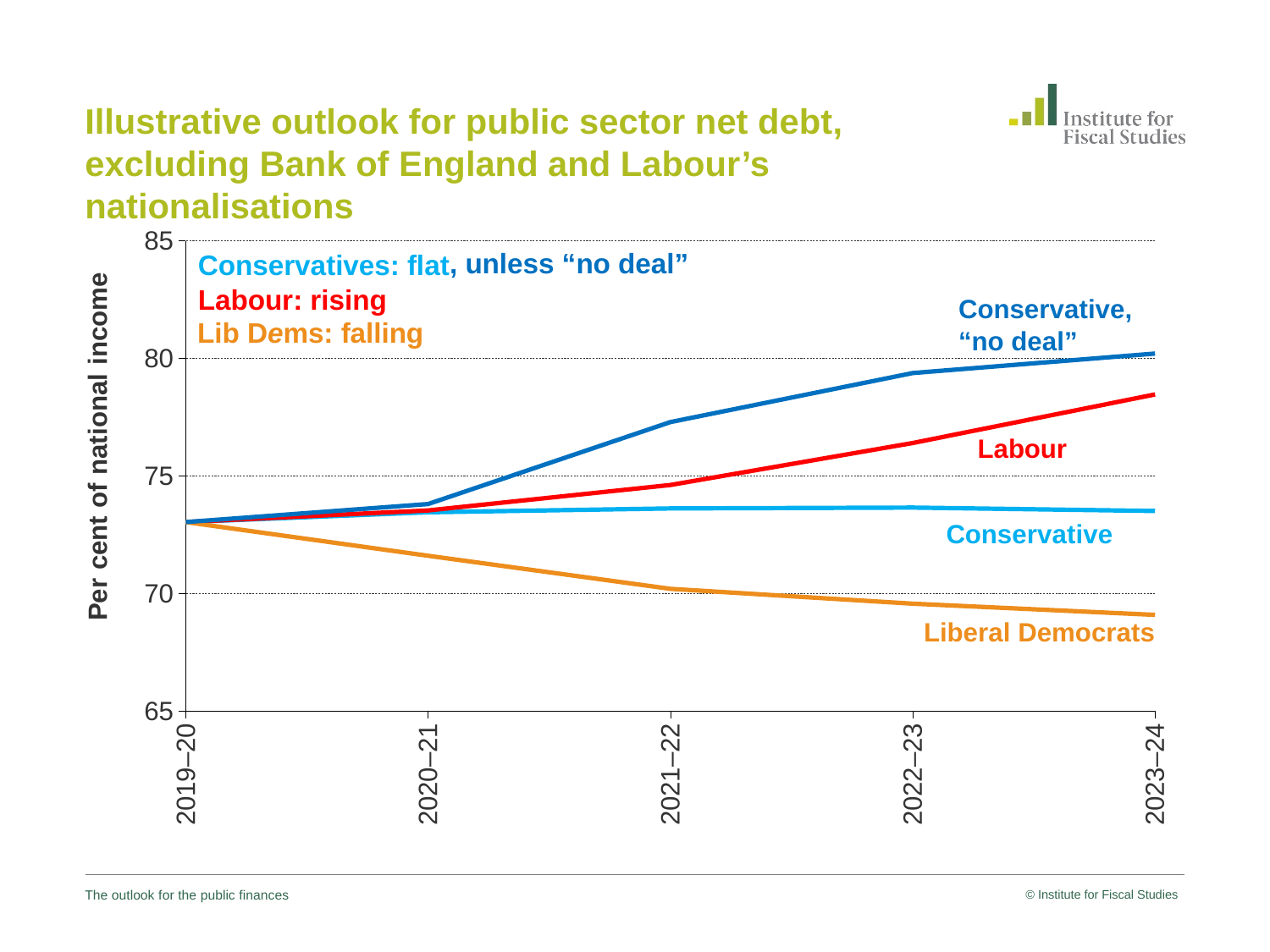
In 2023–24, which is larger: the value for Labour or the value for Conservative? Labour How many fiscal years are shown on the x axis? 5 Does the Labour line rise or fall from 2019–20 to 2023–24? rises Is the value for Conservative in 2023–24 greater or less than 75? less What kind of chart is shown on the slide? line chart Is the value for Liberal Democrats in 2023–24 greater or less than 70? less Is the value for Labour in 2023–24 greater or less than 75? greater How many lines (series) are plotted on the chart? 4 Which series has the highest value in 2023–24? Conservative, "no deal" What is the label on the y axis? Per cent of national income Does the Liberal Democrats line rise or fall from 2019–20 to 2023–24? falls Which series has the lowest value in 2023–24? Liberal Democrats